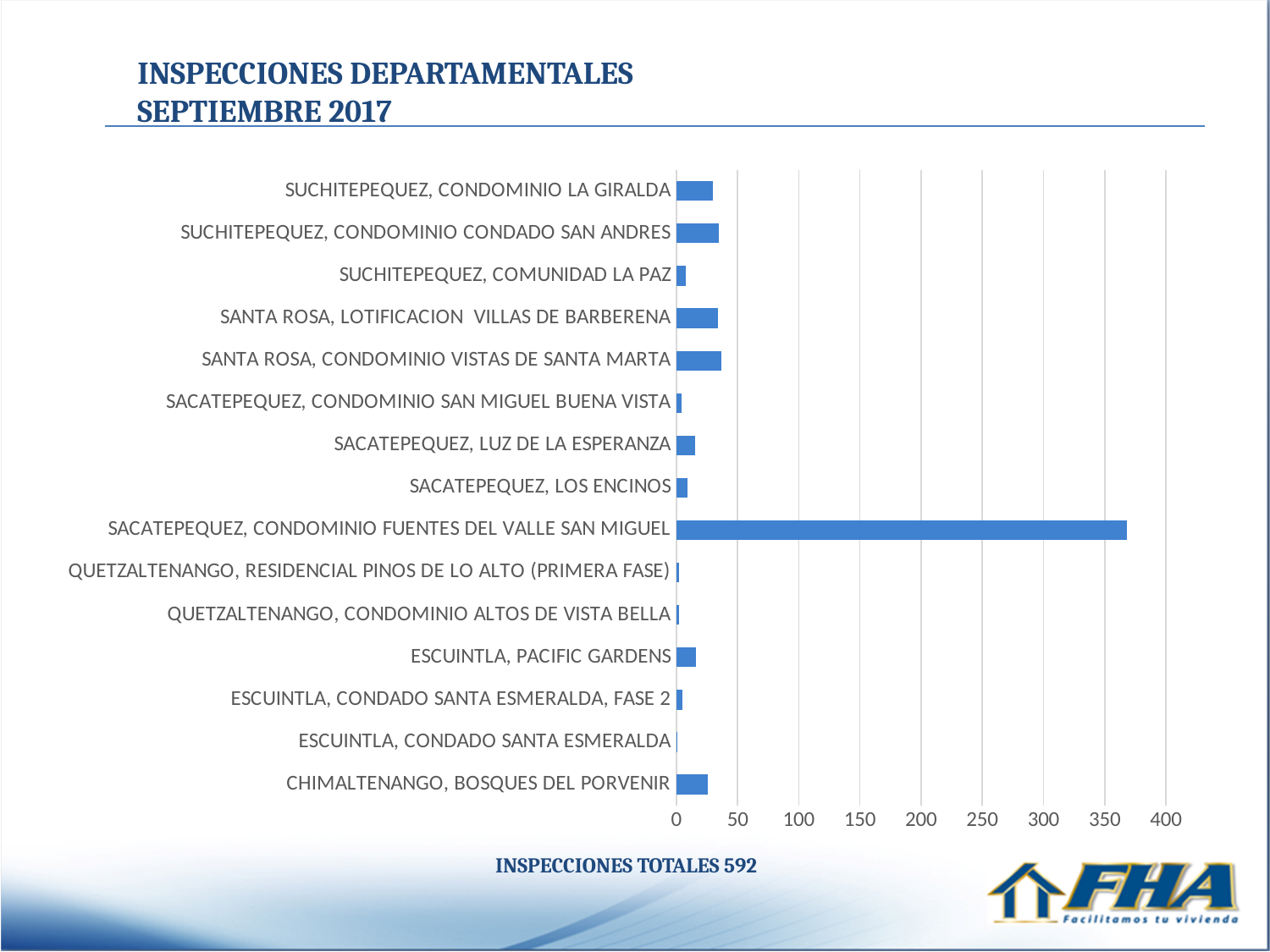
Is the value for SACATEPEQUEZ, CONDOMINIO FUENTES DEL VALLE SAN MIGUEL greater or less than 400? less What is the highest value shown on the horizontal axis of the chart? 400 What is the title of the chart on the slide? INSPECCIONES DEPARTAMENTALES SEPTIEMBRE 2017 Which is larger: the value for SUCHITEPEQUEZ, CONDOMINIO CONDADO SAN ANDRES or the value for SACATEPEQUEZ, CONDOMINIO SAN MIGUEL BUENA VISTA? SUCHITEPEQUEZ, CONDOMINIO CONDADO SAN ANDRES Which is larger: the value for SANTA ROSA, CONDOMINIO VISTAS DE SANTA MARTA or the value for SUCHITEPEQUEZ, COMUNIDAD LA PAZ? SANTA ROSA, CONDOMINIO VISTAS DE SANTA MARTA What kind of chart is shown on the slide? bar chart Is the value for SACATEPEQUEZ, CONDOMINIO FUENTES DEL VALLE SAN MIGUEL greater or less than 350? greater Which category has the highest value in the chart? SACATEPEQUEZ, CONDOMINIO FUENTES DEL VALLE SAN MIGUEL How many categories (projects) are plotted in the chart? 15 Is the value for SANTA ROSA, CONDOMINIO VISTAS DE SANTA MARTA greater or less than 50? less Which is larger: the value for SACATEPEQUEZ, CONDOMINIO FUENTES DEL VALLE SAN MIGUEL or the value for CHIMALTENANGO, BOSQUES DEL PORVENIR? SACATEPEQUEZ, CONDOMINIO FUENTES DEL VALLE SAN MIGUEL